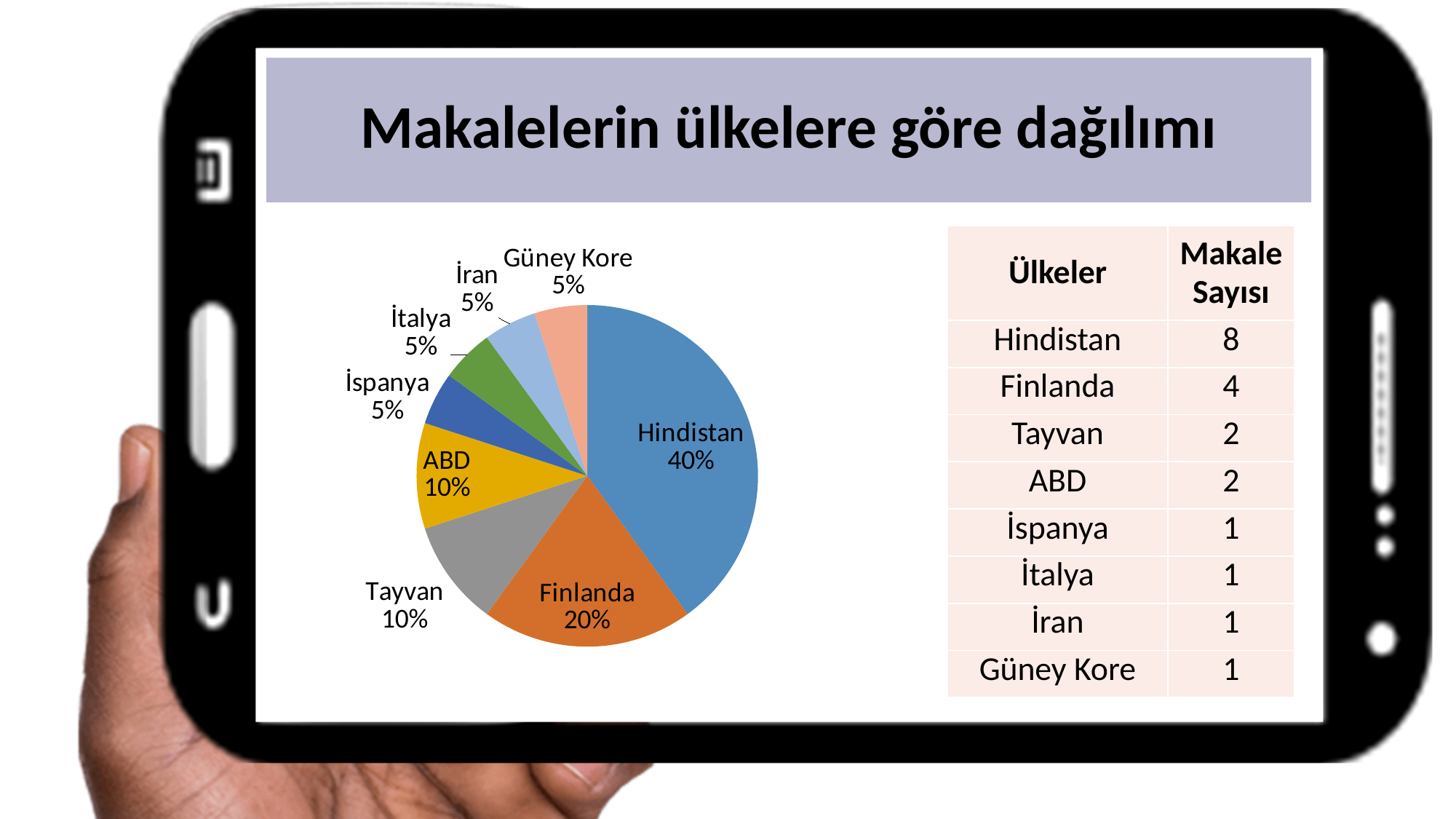
What is the title of the slide containing the pie chart? Makalelerin ülkelere göre dağılımı What is the difference in percentage points between ABD and İspanya? 5% What share of the pie does Finlanda have? 20% What share of the pie does Hindistan have? 40% Which slice is larger, Tayvan or Finlanda? Finlanda What is the difference in percentage points between Hindistan and Finlanda? 20% What colour is the Hindistan slice of the pie chart? blue What percentage is shown for Güney Kore in the pie chart? 5% What kind of chart is shown on the slide? pie chart Which country has the largest slice of the pie? Hindistan How many slices does the pie chart have? 8 What percentage is shown for ABD in the pie chart? 10%